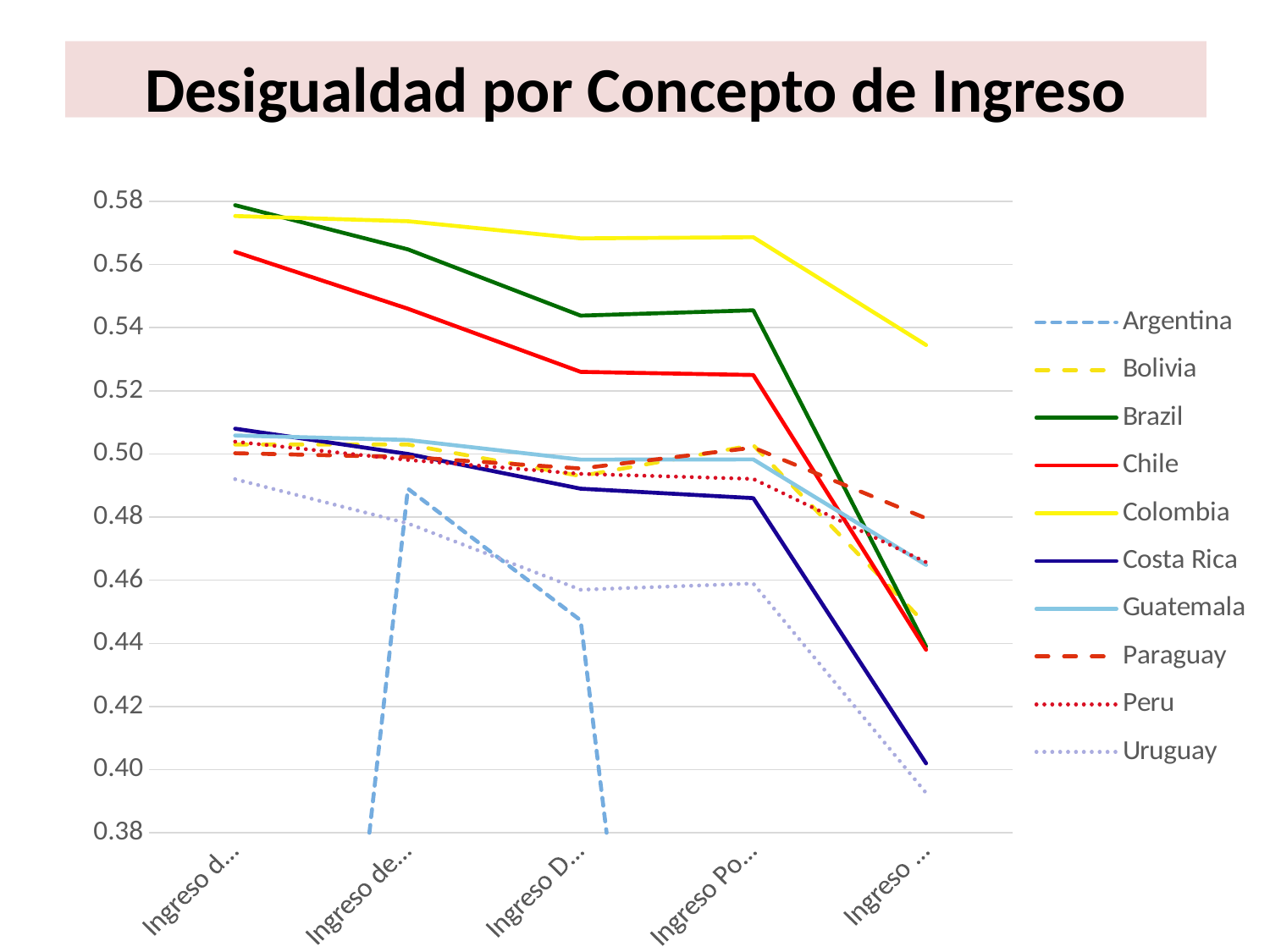
How many series does the legend list? 10 Is the value for Costa Rica at the last x-axis point greater or less than 0.42? less What kind of chart is shown on the slide? line chart At the last x-axis point, which is larger, the value for Colombia or the value for Brazil? Colombia Is the value for Uruguay at the first x-axis point greater or less than 0.50? less Which series has the highest value at the last point on the x axis? Colombia Does the Colombia line rise or fall from the first to the last point on the x axis? fall How many points are there along the x axis? 5 Which series has the lowest value at the last point on the x axis? Uruguay What is the title of the chart? Desigualdad por Concepto de Ingreso Is the value for Chile at the first x-axis point greater or less than 0.54? greater